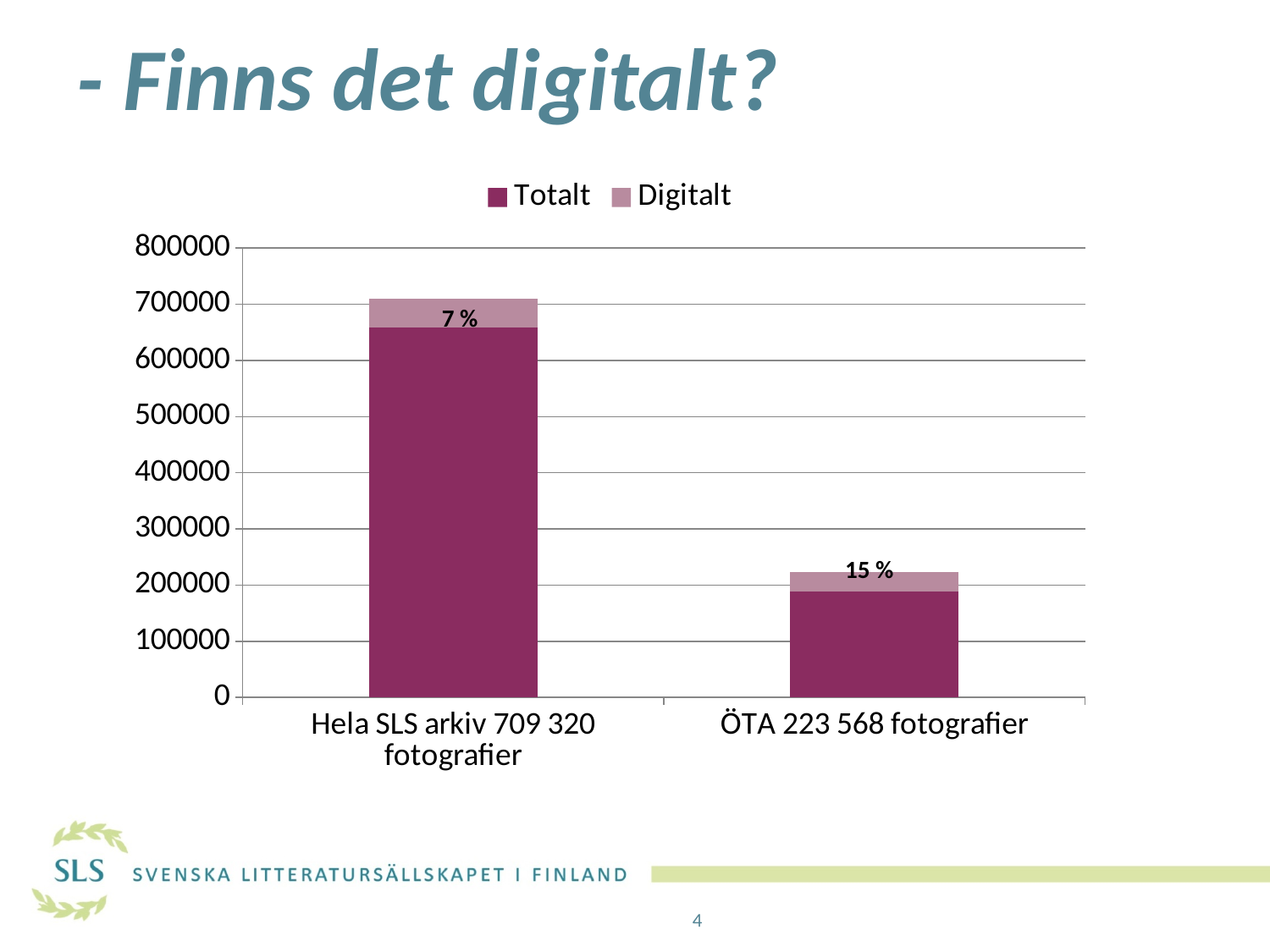
What percentage label is shown on the Digitalt segment for Hela SLS arkiv? 7 % How many series does the legend list? 2 What percentage label is shown on the Digitalt segment for ÖTA? 15 % Is the total height of the Hela SLS arkiv bar greater or less than 600000? greater Which category has the taller stacked bar? Hela SLS arkiv 709 320 fotografier How many categories are shown on the x axis? 2 What kind of chart is shown on the slide? bar chart According to the category label, how many photographs are in Hela SLS arkiv? 709 320 Which category has the higher digital percentage, Hela SLS arkiv or ÖTA? ÖTA Is the total height of the ÖTA bar greater or less than 300000? less What are the two series named in the legend? Totalt and Digitalt What is the title of the slide? - Finns det digitalt?